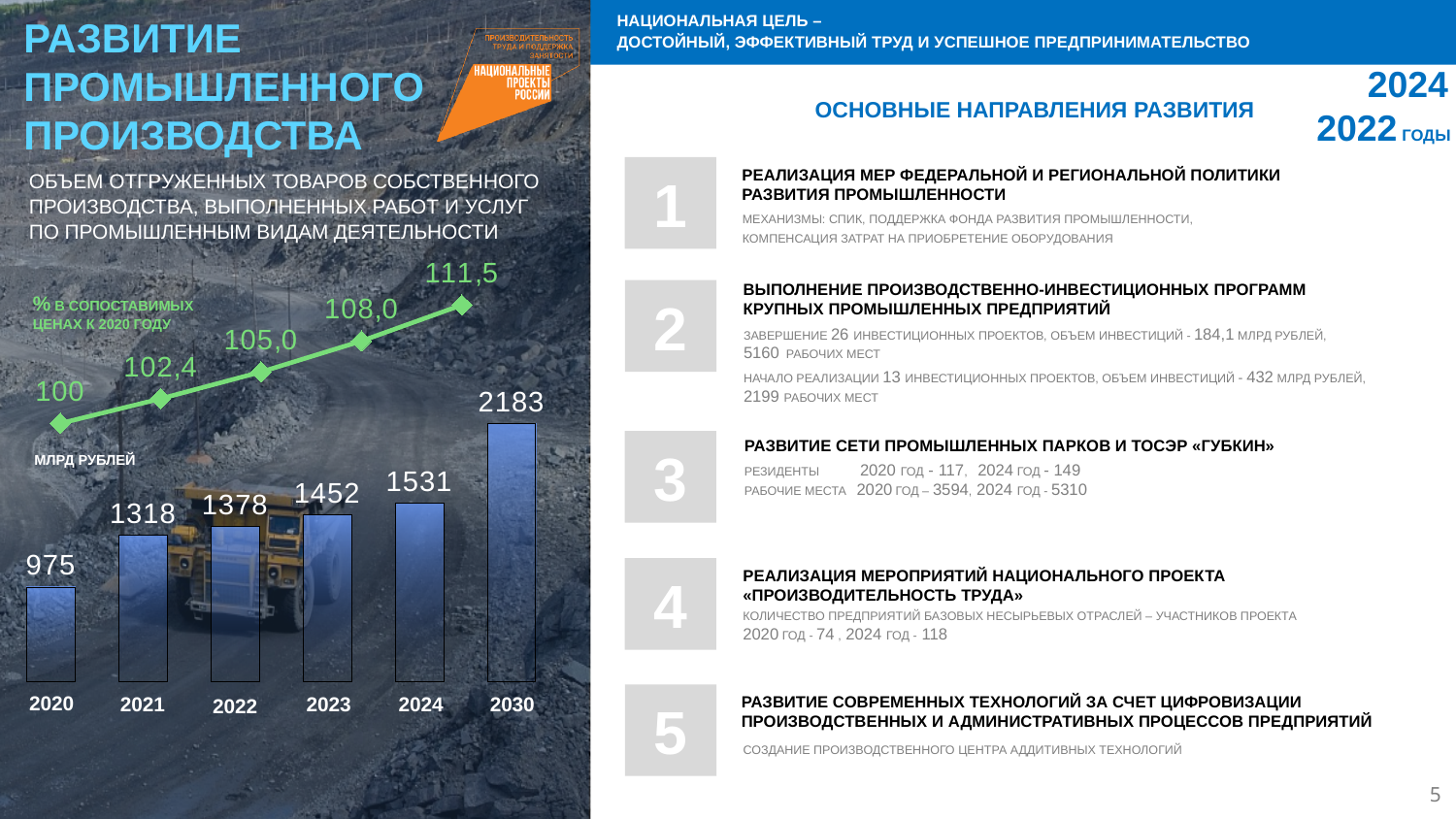
What is the value of the bar for 2020 (млрд рублей)? 975 Which is larger, the bar value for 2022 or for 2023? 2023 What unit is shown for the bars in the chart? млрд рублей What is the value of the bar for 2030 (млрд рублей)? 2183 Which year has the highest bar value (млрд рублей)? 2030 How many years are shown on the x axis of the chart? 6 Do the bar values (млрд рублей) rise or fall from 2020 to 2030? rise Which year has the lowest bar value (млрд рублей)? 2020 What is the value of the line (% в сопоставимых ценах к 2020 году) for 2023? 108,0 What is the difference between the bar values for 2021 and 2020 (млрд рублей)? 343 What is the value of the line (% в сопоставимых ценах к 2020 году) for 2024? 111,5 What is the difference between the bar values for 2030 and 2024 (млрд рублей)? 652